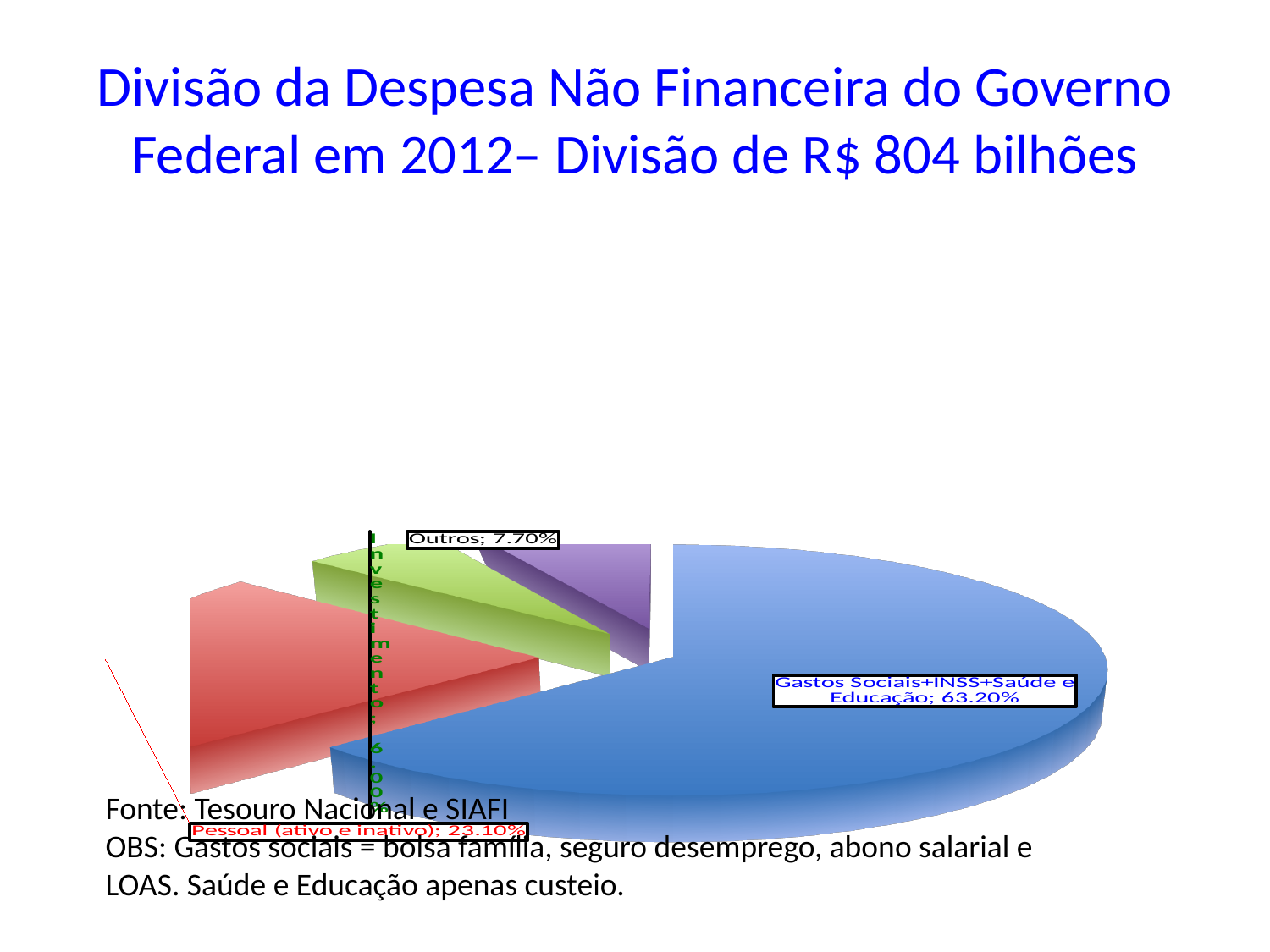
What percentage is shown for the 'Outros' slice? 7.70% Which slice of the pie is the largest? Gastos Sociais+INSS+Saúde e Educação What kind of chart is shown on the slide? pie chart Which is larger, the share for 'Pessoal (ativo e inativo)' or the share for 'Outros'? Pessoal (ativo e inativo) By how many percentage points does 'Pessoal (ativo e inativo)' exceed 'Outros'? 15.40 percentage points What is the difference in percentage points between 'Gastos Sociais+INSS+Saúde e Educação' and 'Pessoal (ativo e inativo)'? 40.10 percentage points What share of the pie does the slice 'Gastos Sociais+INSS+Saúde e Educação' represent? 63.20% How many slices does the pie chart have? 4 What percentage is shown for 'Pessoal (ativo e inativo)'? 23.10% What colour is the largest slice of the pie chart? blue What is the title of the slide containing the pie chart? Divisão da Despesa Não Financeira do Governo Federal em 2012– Divisão de R$ 804 bilhões